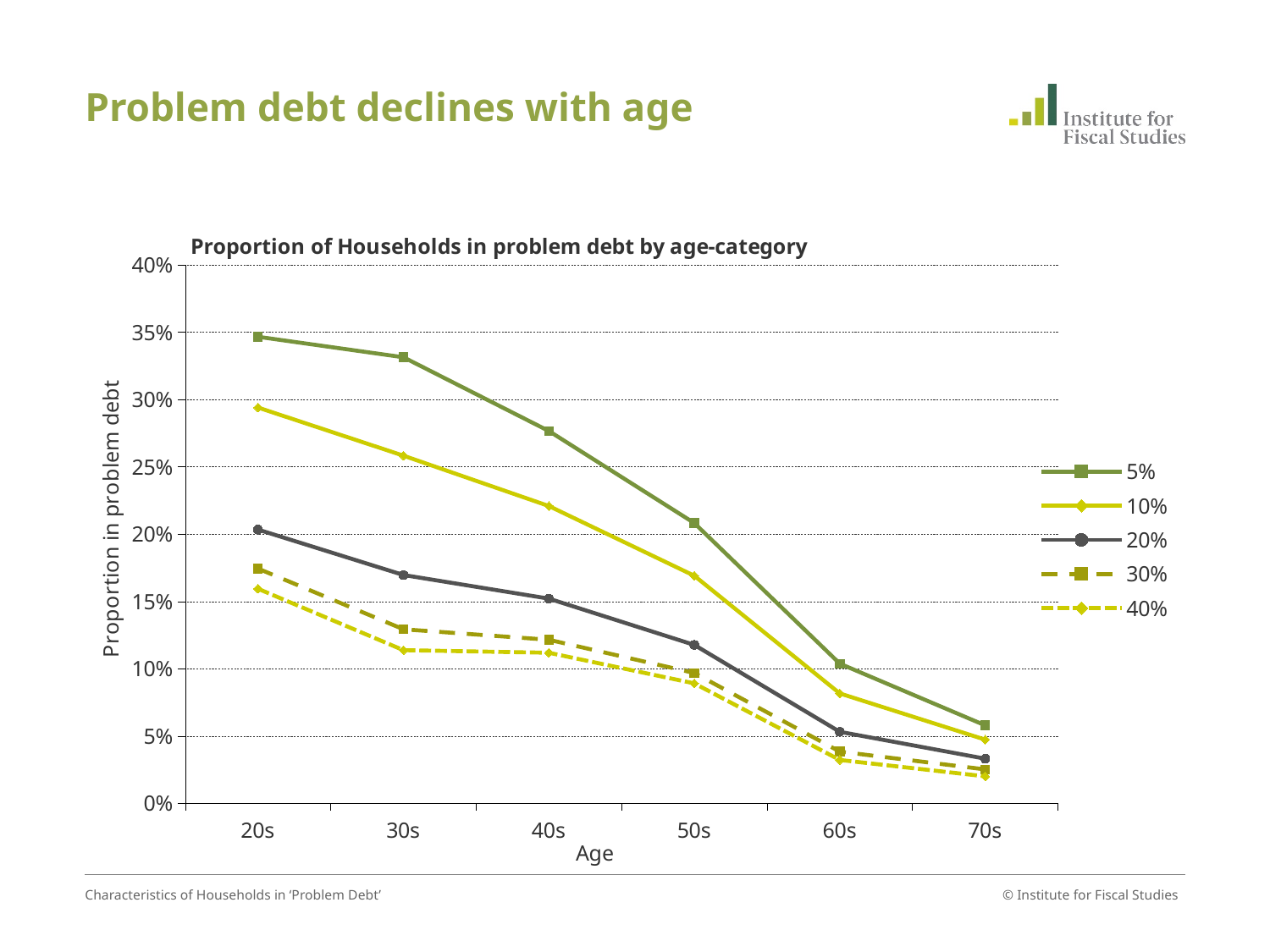
What is the label on the y axis? Proportion in problem debt At 40s, which series has the larger value, 5% or 20%? 5% What kind of chart is shown on the slide? line chart Is the value for the 5% series at 20s greater or less than 30%? greater Which age category has the highest value for the 5% series? 20s How many series does the legend list? 5 Do the values for the 5% series rise or fall as age increases from 20s to 70s? fall Is the value for the 10% series at 50s greater or less than 20%? less Which age category has the lowest value for the 10% series? 70s How many age categories are shown on the x axis? 6 Is the value for the 30% series at 60s greater or less than 5%? less What is the title of the chart? Proportion of Households in problem debt by age-category